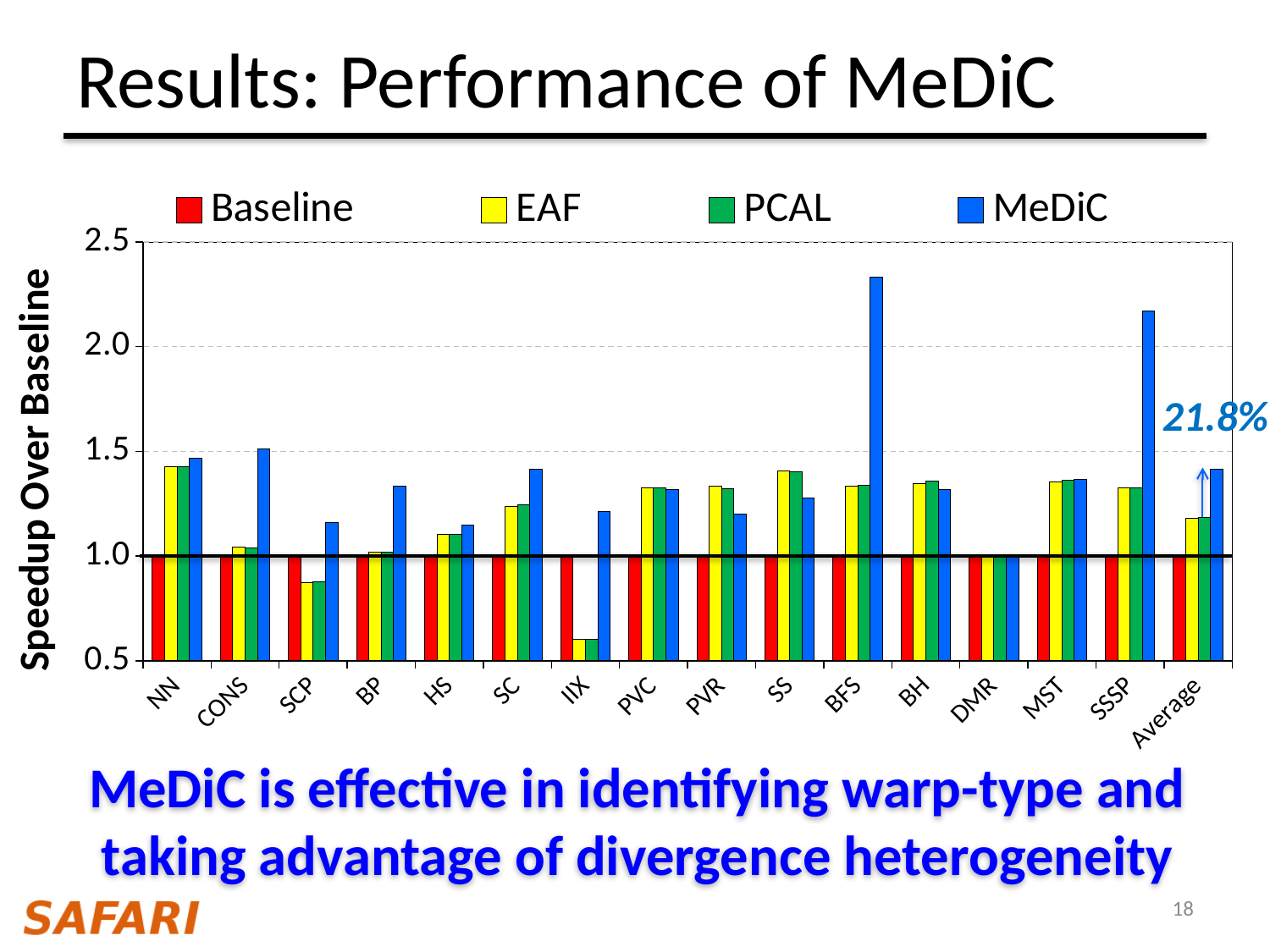
How many categories are shown along the x axis? 16 Is the MeDiC value for SCP greater or less than 1.5? less Which category has the lowest EAF bar? IIX Which category has the highest MeDiC bar? BFS Is the MeDiC value for BFS greater or less than 2.0? greater For IIX, which is larger: the MeDiC bar or the PCAL bar? MeDiC Is the EAF value for IIX greater or less than 1.0? less What percentage is annotated above the Average bars? 21.8% For PVR, which is larger: the EAF bar or the MeDiC bar? EAF How many series does the legend list? 4 What is the Baseline value for NN? 1.0 What kind of chart is shown on the slide? bar chart